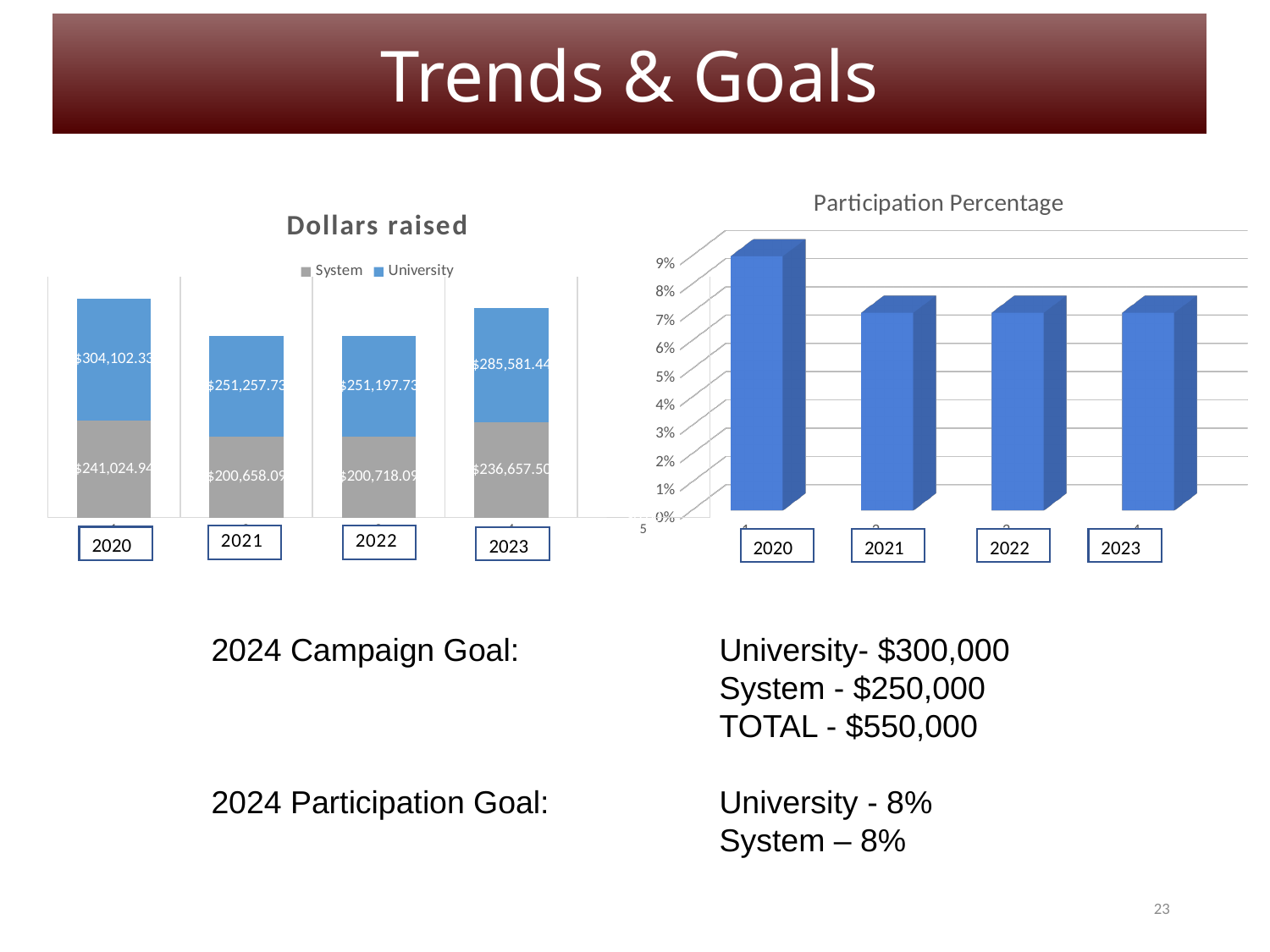
In the Dollars raised chart, what is the difference between the University values for 2020 and 2023? $18,520.89 In the Dollars raised chart, which year has the highest University value? 2020 In the Participation Percentage chart, is the value for 2021 greater or less than 8%? less In the Dollars raised chart, what is the University value for 2020? $304,102.33 In the Dollars raised chart, what is the total of the stacked bar for 2020? $545,127.27 What kind of chart is the Participation Percentage chart? bar chart In the Dollars raised chart, is the University value for 2021 larger or smaller than the University value for 2023? smaller How many series does the legend of the Dollars raised chart list? 2 In the Participation Percentage chart, which year has the highest value? 2020 In the Dollars raised chart, which year has the lowest System value? 2021 In the Dollars raised chart, what is the System value for 2021? $200,658.09 In the Dollars raised chart, what is the System value for 2023? $236,657.50